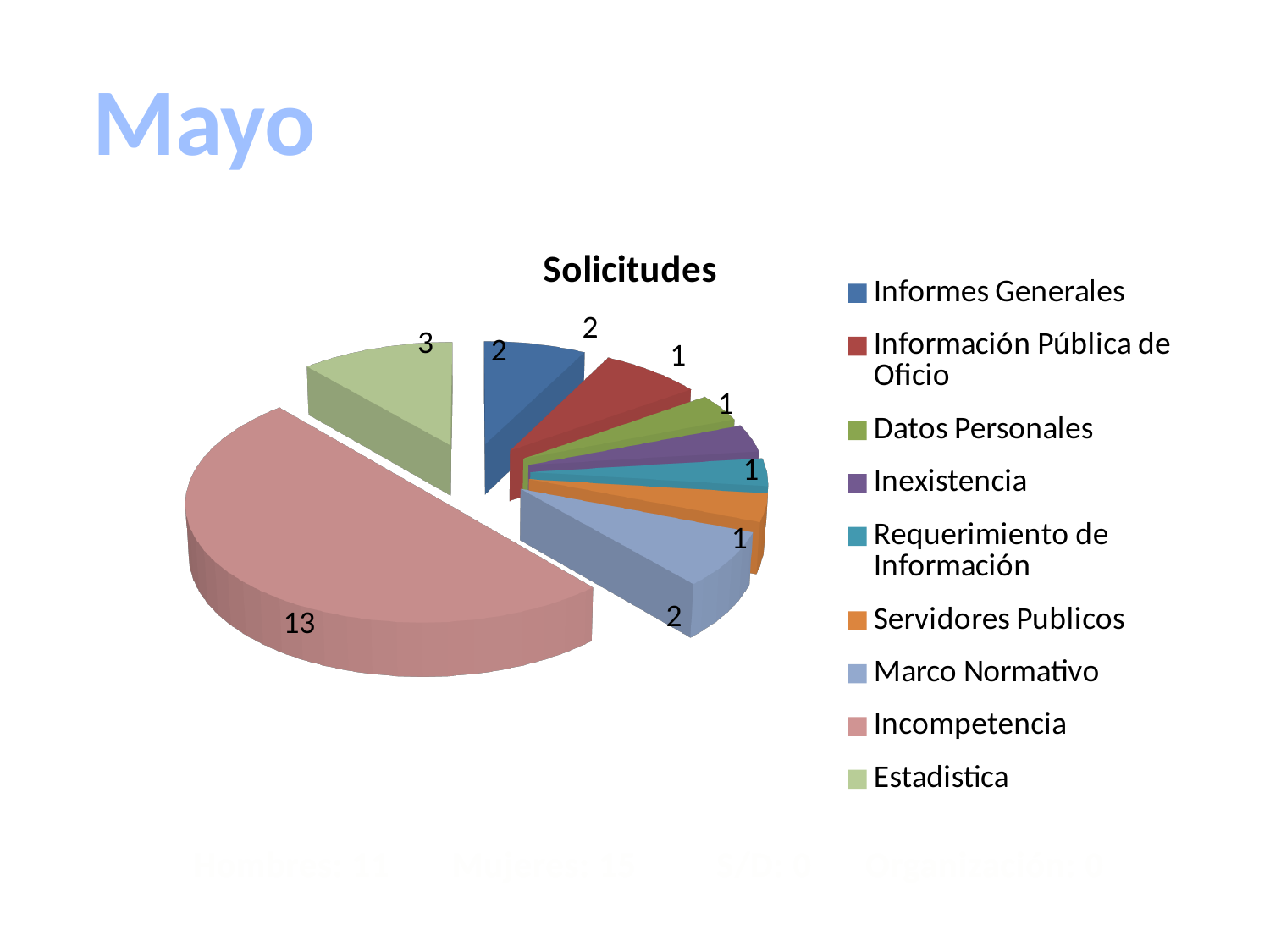
What is the value for Informes Generales in the Solicitudes chart? 2 What is the title of the chart? Solicitudes What share of the Solicitudes pie does Incompetencia represent? 50% What is the difference between the values for Incompetencia and Estadistica? 10 What is the value for Estadistica in the Solicitudes chart? 3 What is the total of all values shown in the Solicitudes chart? 26 Which category has the largest slice in the Solicitudes chart? Incompetencia What is the value for Incompetencia in the Solicitudes chart? 13 Which is larger, the value for Estadistica or the value for Marco Normativo? Estadistica How many categories does the legend of the Solicitudes chart list? 9 What kind of chart is shown on the slide? Pie chart What is the value for Marco Normativo in the Solicitudes chart? 2